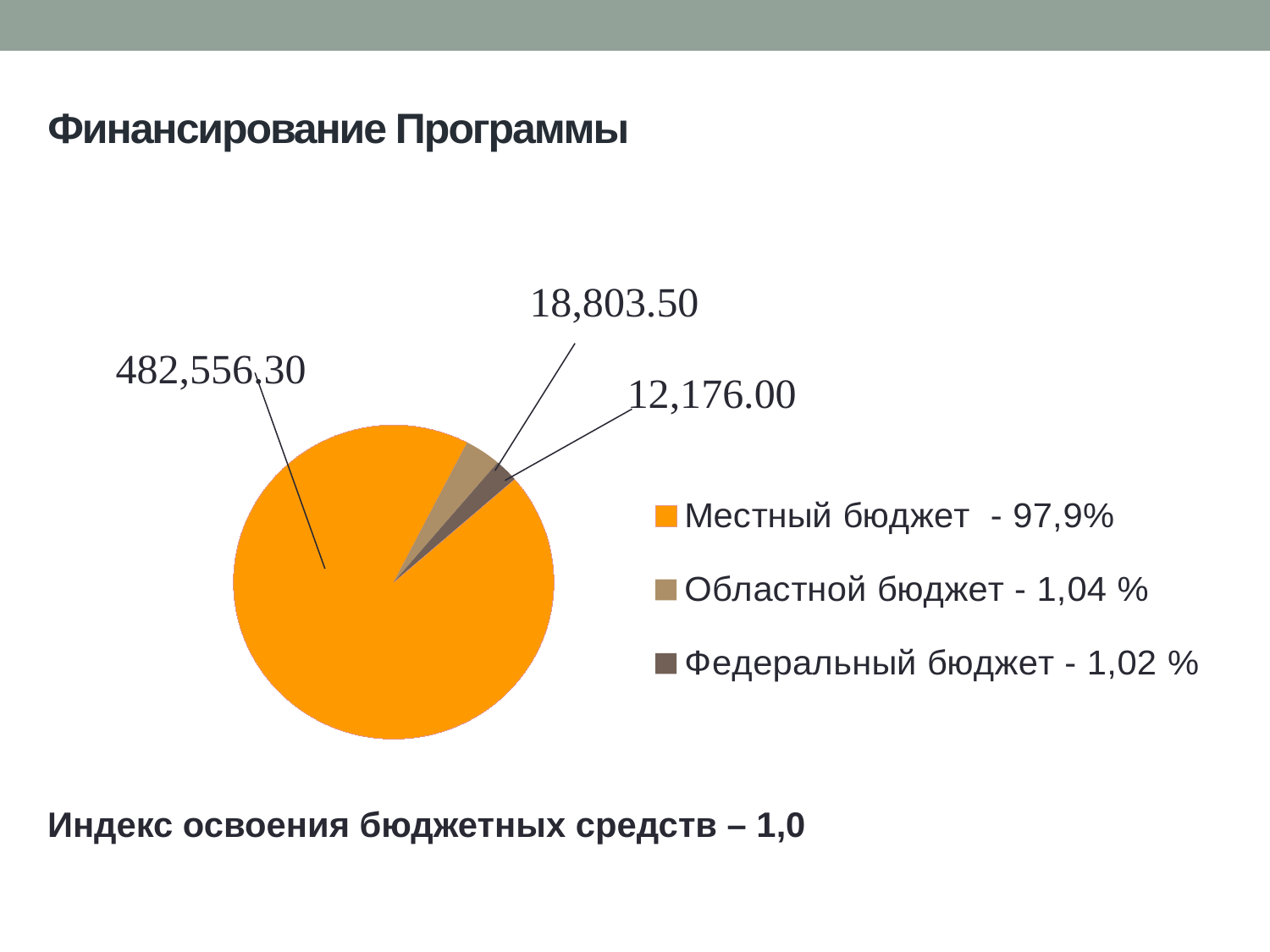
Which is larger, the value for Областной бюджет or the value for Федеральный бюджет? Областной бюджет What is the value shown for Местный бюджет? 482,556.30 What is the difference between the values for Областной бюджет and Федеральный бюджет? 6,627.50 Which budget source has the largest slice of the pie? Местный бюджет Which budget source has the smallest slice of the pie? Федеральный бюджет What is the title of the slide containing the pie chart? Финансирование Программы How many slices does the pie chart have? 3 What is the difference between the values for Местный бюджет and Областной бюджет? 463,752.80 What is the value shown for Федеральный бюджет? 12,176.00 What kind of chart is shown on the slide? Pie chart According to the legend, what percentage share is given for Областной бюджет? 1,04 % What is the value shown for Областной бюджет? 18,803.50